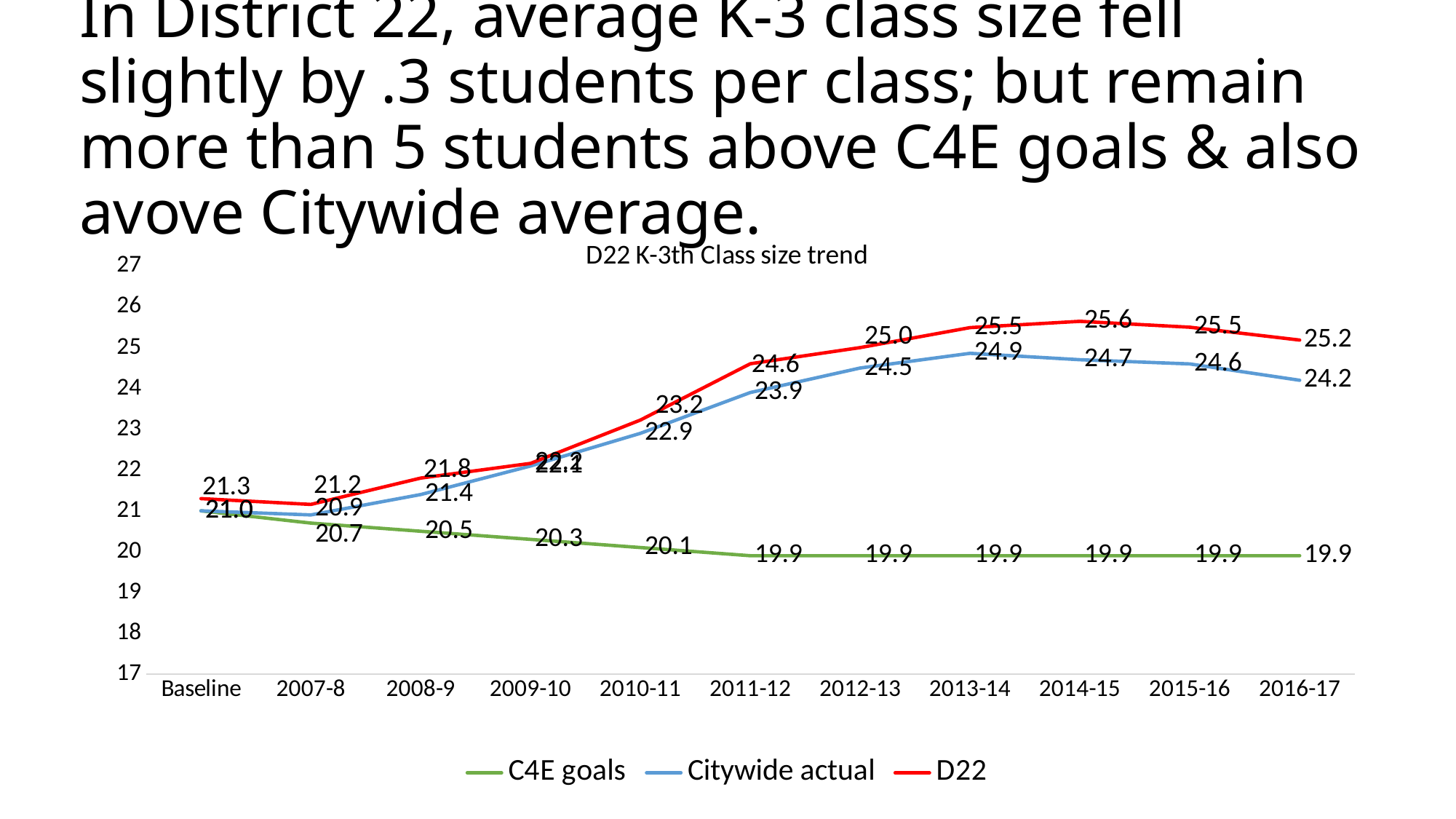
What is the Citywide actual value for 2013-14? 24.9 In 2012-13, which is larger: the D22 value or the Citywide actual value? D22 In which year is the Citywide actual series at its lowest value? 2007-8 What is the difference between the D22 and Citywide actual values in 2016-17? 1.0 How many points are plotted along the x axis? 11 What is the C4E goals value for 2010-11? 20.1 What is the title of the chart? D22 K-3th Class size trend In which year does the D22 series reach its highest value? 2014-15 What kind of chart is shown on the slide? Line chart What is the D22 value for 2016-17? 25.2 Does the C4E goals series rise or fall from Baseline to 2011-12? Fall How many series does the legend list? 3